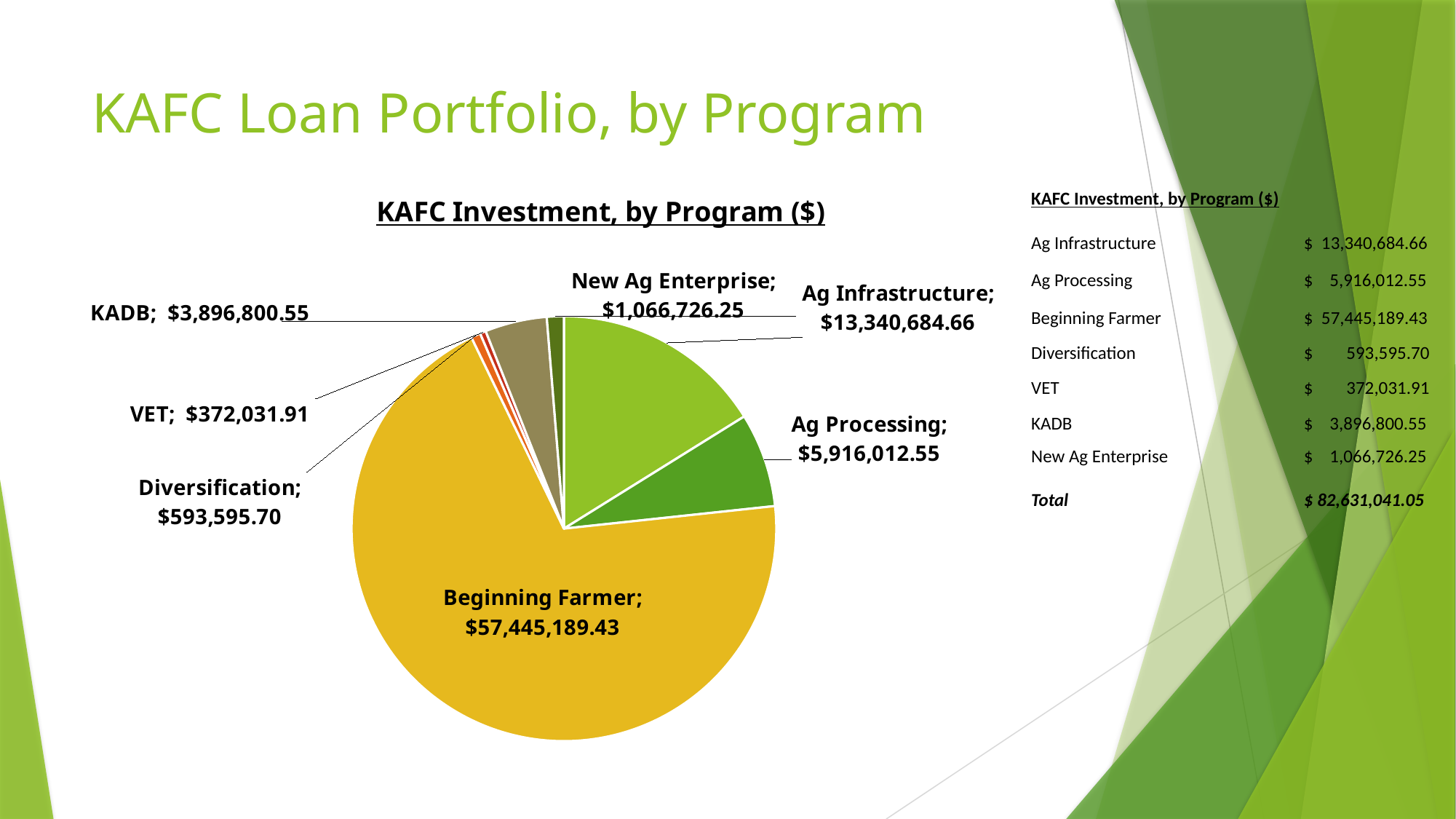
What is the title of the chart? KAFC Investment, by Program ($) What is the investment value for New Ag Enterprise? $1,066,726.25 What is the investment value for Beginning Farmer? $57,445,189.43 Which program has the smallest investment? VET How many program categories are shown in the pie chart? 7 What is the difference between the Ag Infrastructure and Ag Processing investments? $7,424,672.11 What is the difference between the KADB and New Ag Enterprise investments? $2,830,074.30 Which is larger, the investment for Ag Infrastructure or for Ag Processing? Ag Infrastructure What type of chart is shown on the slide? Pie chart What is the investment value for Ag Infrastructure? $13,340,684.66 Which program has the largest investment? Beginning Farmer What is the investment value for VET? $372,031.91